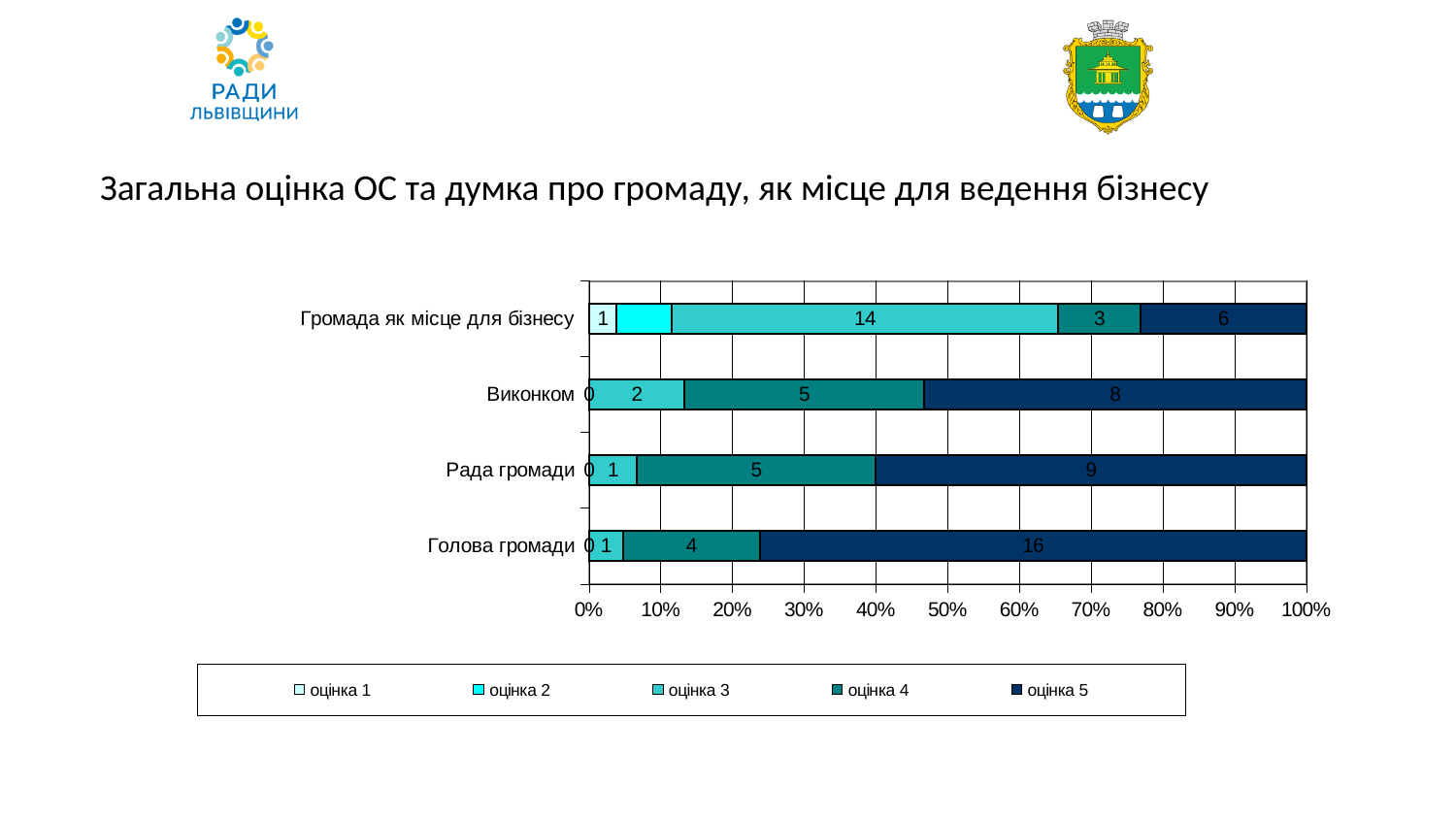
How many series does the legend list? 5 What is the difference between the оцінка 5 values for Голова громади and Рада громади? 7 What is the value of оцінка 4 for Виконком? 5 What is the value of оцінка 5 for Голова громади? 16 What is the value of оцінка 1 for Громада як місце для бізнесу? 1 What is the title of the chart on the slide? Загальна оцінка ОС та думка про громаду, як місце для ведення бізнесу Which category has the highest value for оцінка 5? Голова громади What is the value of оцінка 5 for Рада громади? 9 What kind of chart is shown on the slide? Stacked bar chart What is the value of оцінка 3 for Громада як місце для бізнесу? 14 Which has the larger оцінка 4 value: Громада як місце для бізнесу or Рада громади? Рада громади How many categories are shown on the vertical axis of the chart? 4